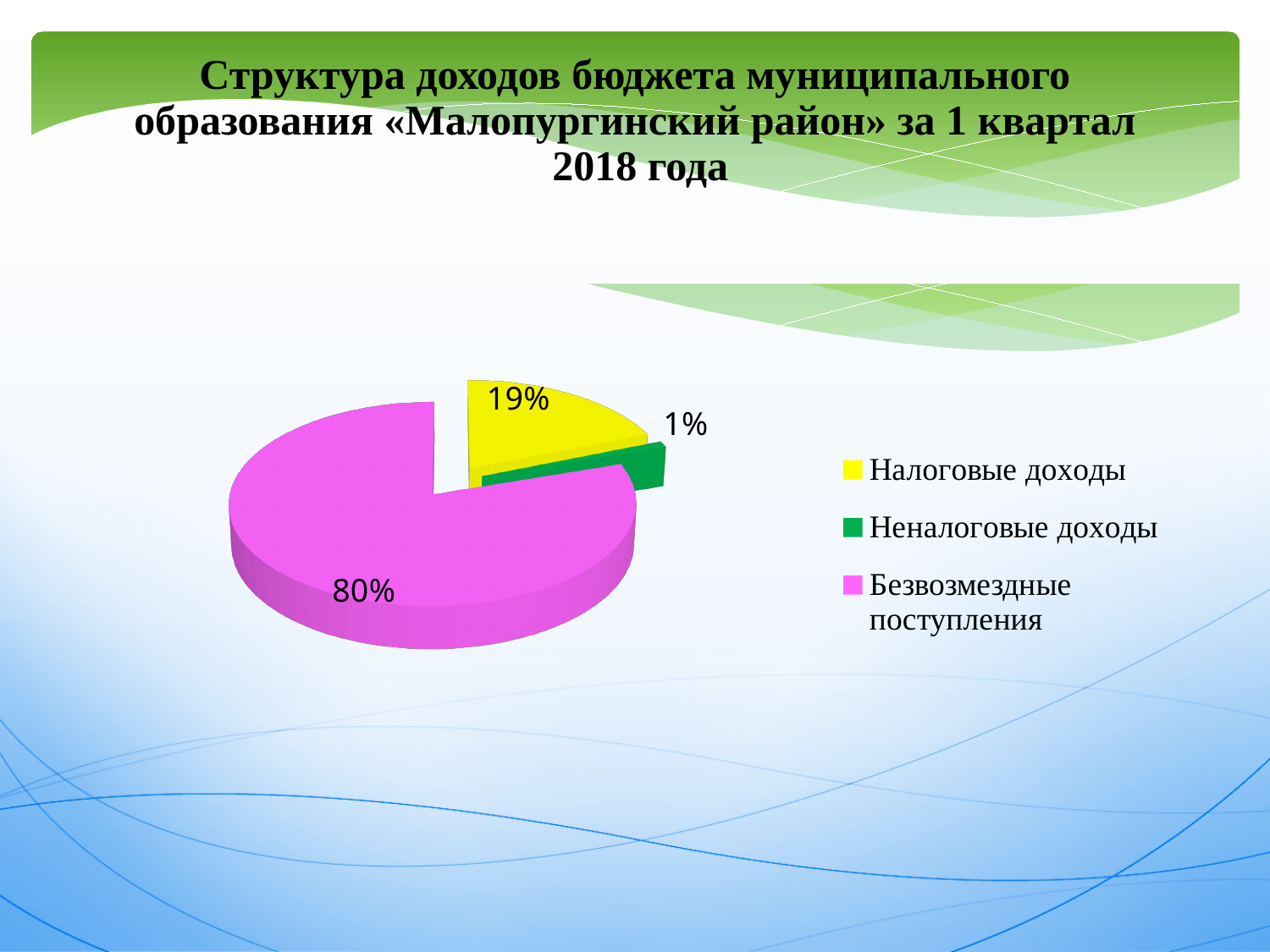
Which category has the largest slice of the pie? Безвозмездные поступления Which category has the smallest slice of the pie? Неналоговые доходы Which category is shown in green in the legend? Неналоговые доходы Which is larger, the share for Налоговые доходы or the share for Неналоговые доходы? Налоговые доходы How many categories does the pie chart show? 3 What share of the pie does Неналоговые доходы hold? 1% What share of the pie does Налоговые доходы hold? 19% What kind of chart is shown on the slide? pie chart What colour is the slice for Безвозмездные поступления? pink What is the difference in percentage points between Безвозмездные поступления and Налоговые доходы? 61 What share of the pie does Безвозмездные поступления hold? 80% What is the difference in percentage points between Налоговые доходы and Неналоговые доходы? 18